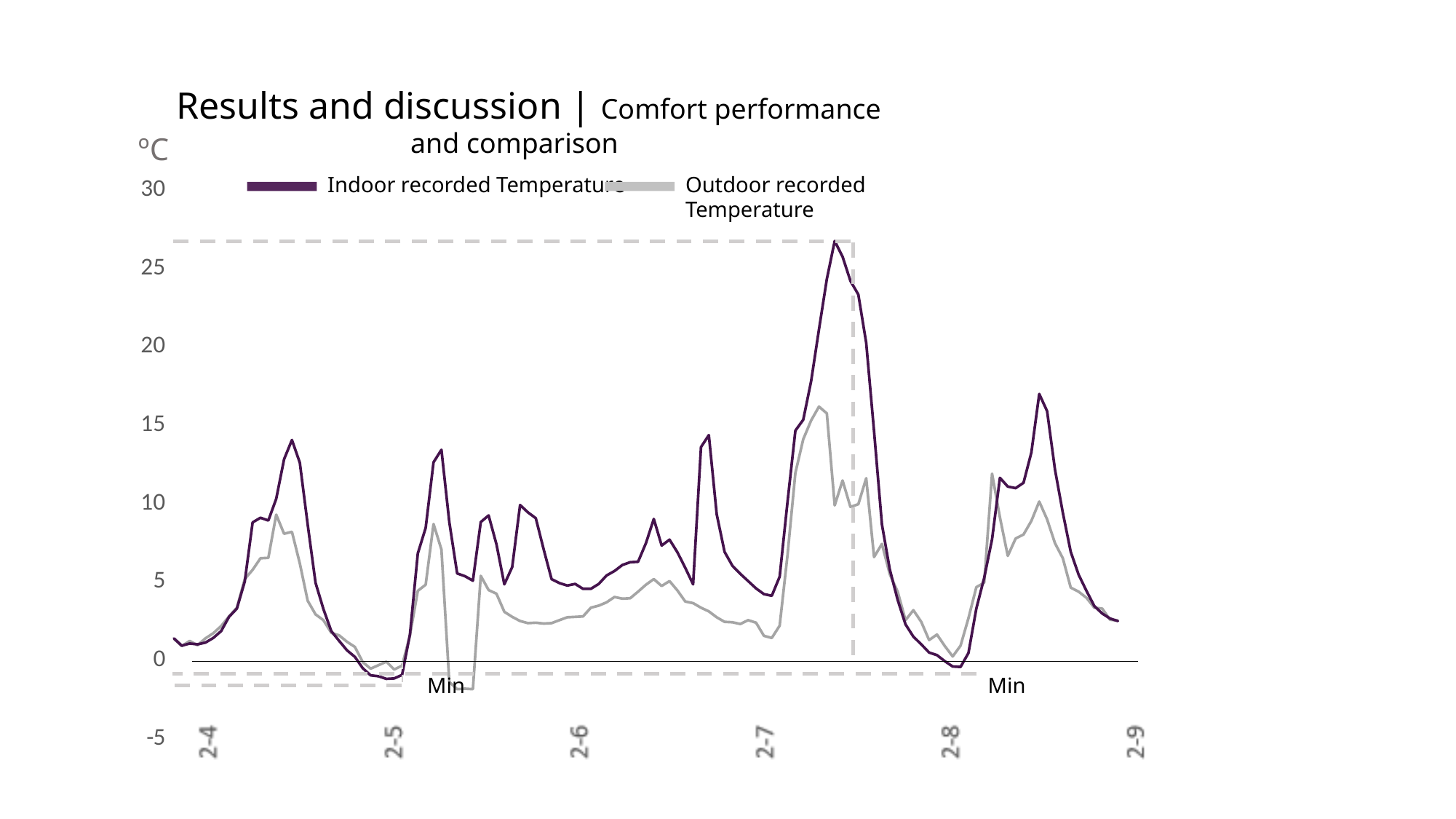
How many date labels are shown along the x axis? 6 Is the lowest value of the Outdoor recorded Temperature greater or less than 0? less Is the highest value of the Indoor recorded Temperature greater or less than 30? less Is the highest value of the Outdoor recorded Temperature greater or less than 20? less What are the two series named in the legend? Indoor recorded Temperature and Outdoor recorded Temperature At the highest peak of the chart, which series is larger, Indoor recorded Temperature or Outdoor recorded Temperature? Indoor recorded Temperature What kind of chart is shown on the slide? line chart Between which two x-axis date labels does the highest peak of the Indoor recorded Temperature occur? 2-7 and 2-8 How many series does the legend list? 2 Which series reaches the highest value on the chart? Indoor recorded Temperature What unit is shown for the vertical axis? °C